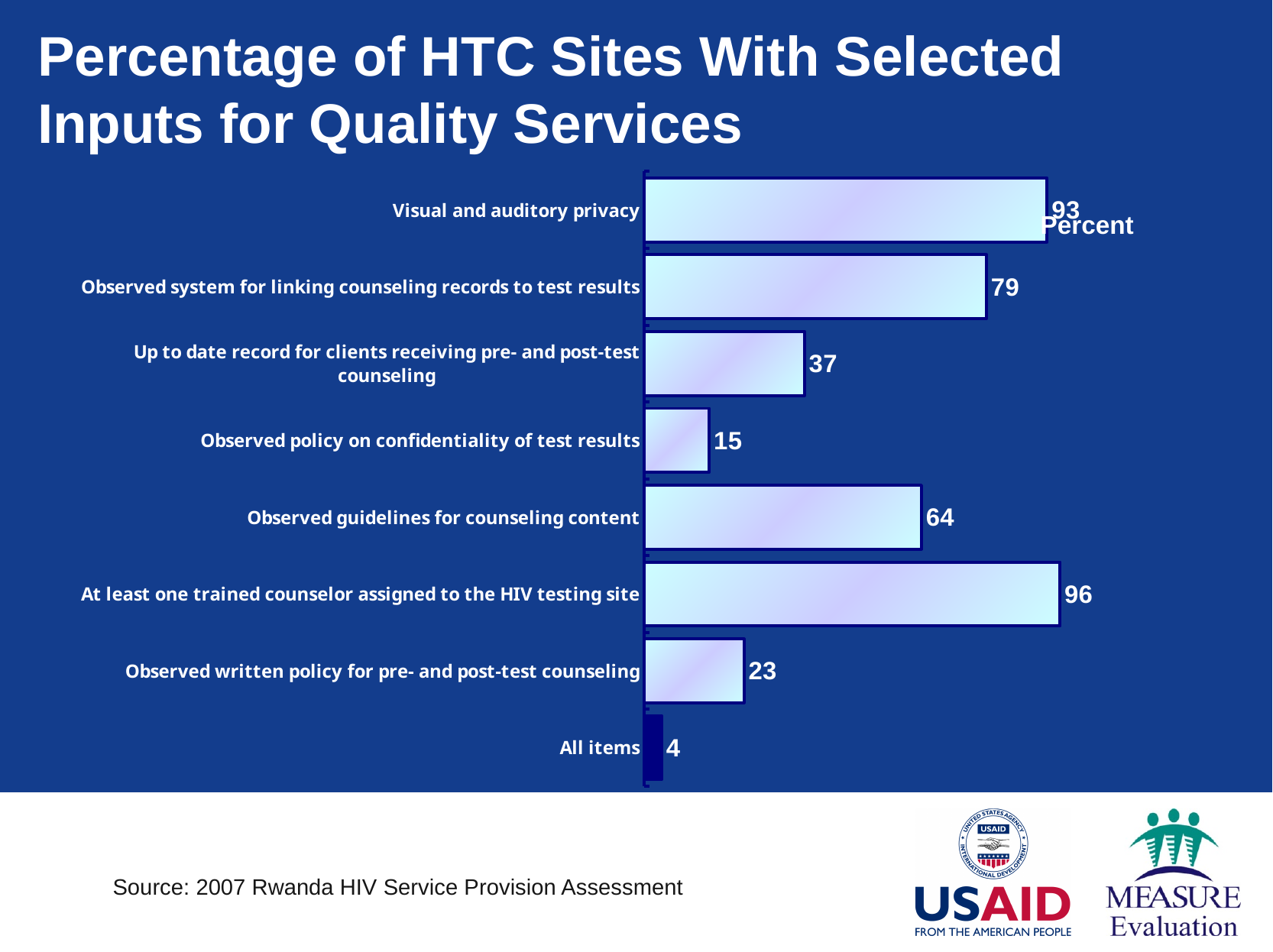
What percentage of HTC sites have visual and auditory privacy? 93 What is the value for 'Observed policy on confidentiality of test results'? 15 Which category has the highest value? At least one trained counselor assigned to the HIV testing site What is the difference between the values for 'Observed system for linking counseling records to test results' and 'Up to date record for clients receiving pre- and post-test counseling'? 42 What is the value for 'Observed written policy for pre- and post-test counseling'? 23 What kind of chart is shown on the slide? Bar chart What is the source cited for the chart data? 2007 Rwanda HIV Service Provision Assessment How many categories are shown in the chart? 8 Which category has the lowest value? All items What is the difference between the highest and lowest values in the chart? 92 Which is larger: the value for 'Observed guidelines for counseling content' or the value for 'Up to date record for clients receiving pre- and post-test counseling'? Observed guidelines for counseling content What percentage of HTC sites have all items? 4